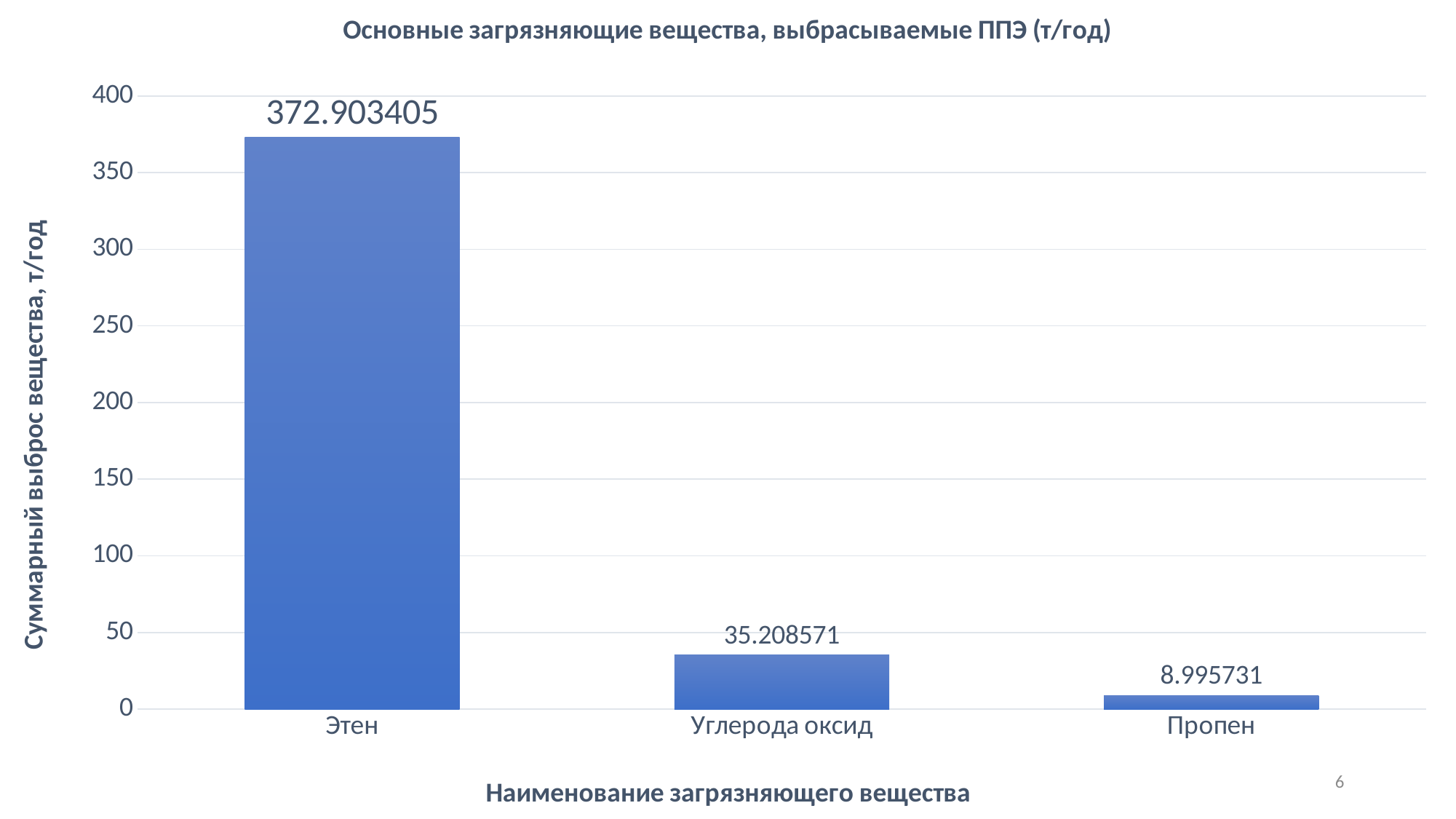
What is the title of the chart? Основные загрязняющие вещества, выбрасываемые ППЭ (т/год) Which category has the lowest value? Пропен Which category has the highest value? Этен What is the value for Пропен? 8.995731 Which is larger, the value for Углерода оксид or the value for Пропен? Углерода оксид What is the difference between the values for Этен and Углерода оксид? 337.694834 What is the value for Углерода оксид? 35.208571 What is the difference between the values for Углерода оксид and Пропен? 26.21284 What is the value for Этен? 372.903405 Is the value for Этен greater or less than 350? greater How many categories are shown on the x axis? 3 What kind of chart is shown on the slide? bar chart